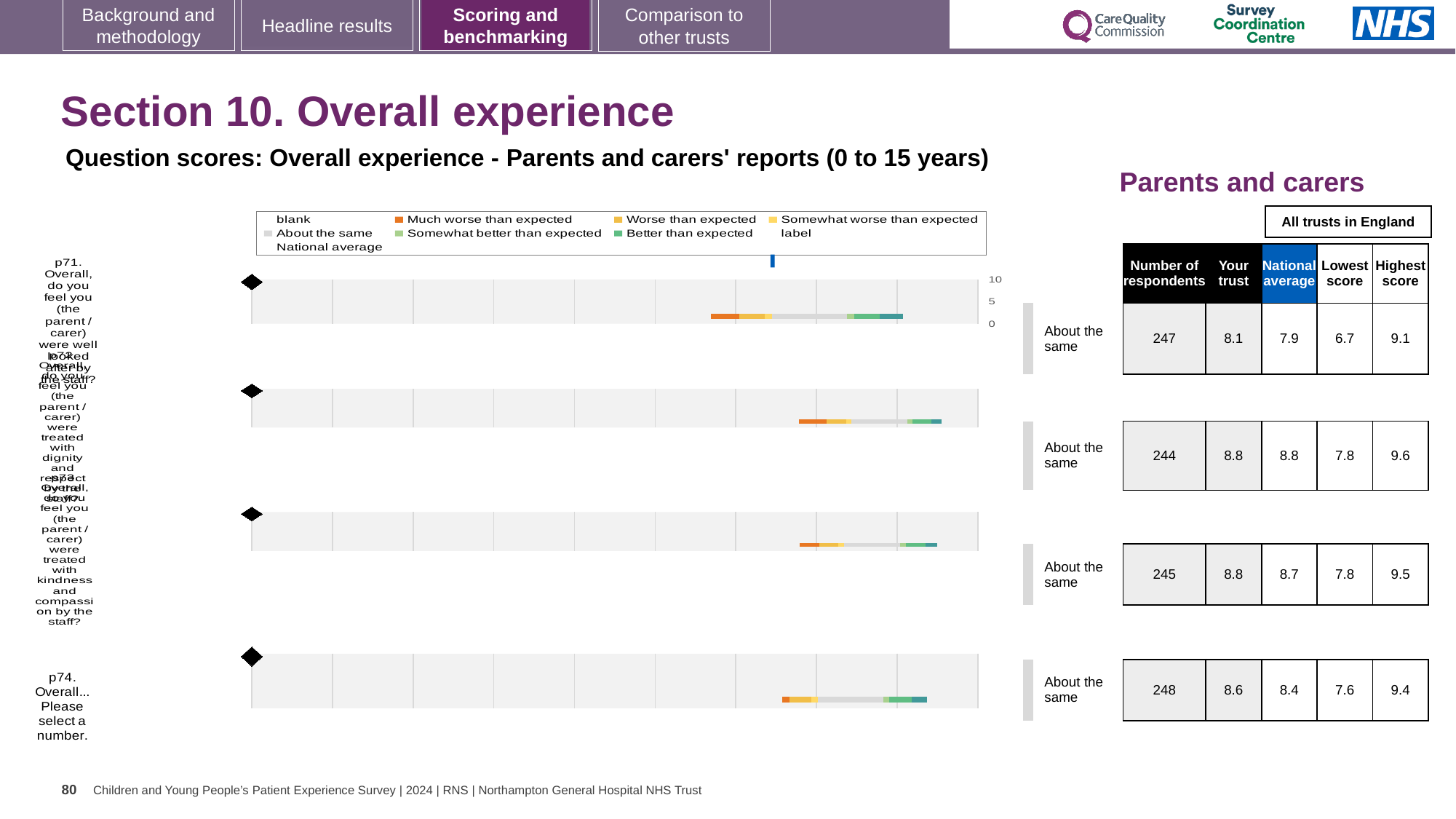
In the table beside the chart, what is the lowest score for p73 (treated with kindness and compassion)? 7.8 For p71, which is larger: the 'Your trust' score or the national average? Your trust How many entries does the legend of the Overall experience chart list? 9 For p74, how much higher is the 'Your trust' score than the national average in the table beside the chart? 0.2 What colour does the legend use for 'Much worse than expected'? orange How many questions (bars) are plotted in the Overall experience chart? 4 In the table beside the chart, how many respondents answered p74 (Overall... Please select a number)? 248 What kind of chart is used to show the question scores for Overall experience? bar chart What benchmark category is shown next to the bar for p71? About the same Which question has the lowest 'Your trust' score in the table beside the chart? p71 In the table beside the chart, what is the highest score for p72 (treated with dignity and respect)? 9.6 In the table beside the chart, what is the 'Your trust' score for p71 (were well looked after by the staff)? 8.1